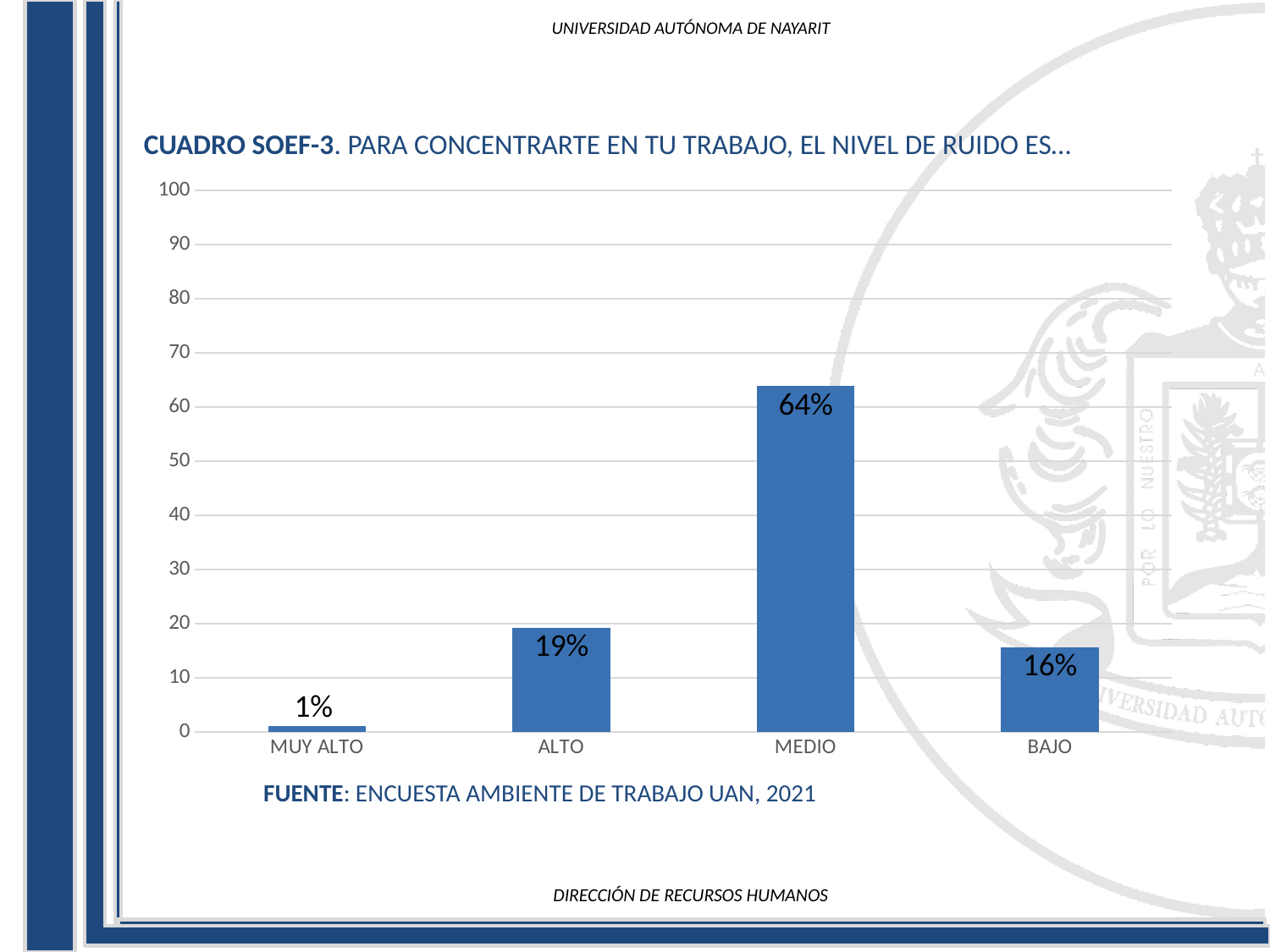
What is the value for MEDIO? 64% What is the value for MUY ALTO? 1% What is the difference between the values for MEDIO and ALTO? 45% What is the value for BAJO? 16% Which category has the highest value? MEDIO What kind of chart is shown on the slide? bar chart Which category has the lowest value? MUY ALTO Is the value for MEDIO greater or less than 60? greater Which is larger, the value for ALTO or the value for BAJO? ALTO What is the difference between the values for ALTO and BAJO? 3% What is the value for ALTO? 19% How many categories are shown on the x axis? 4